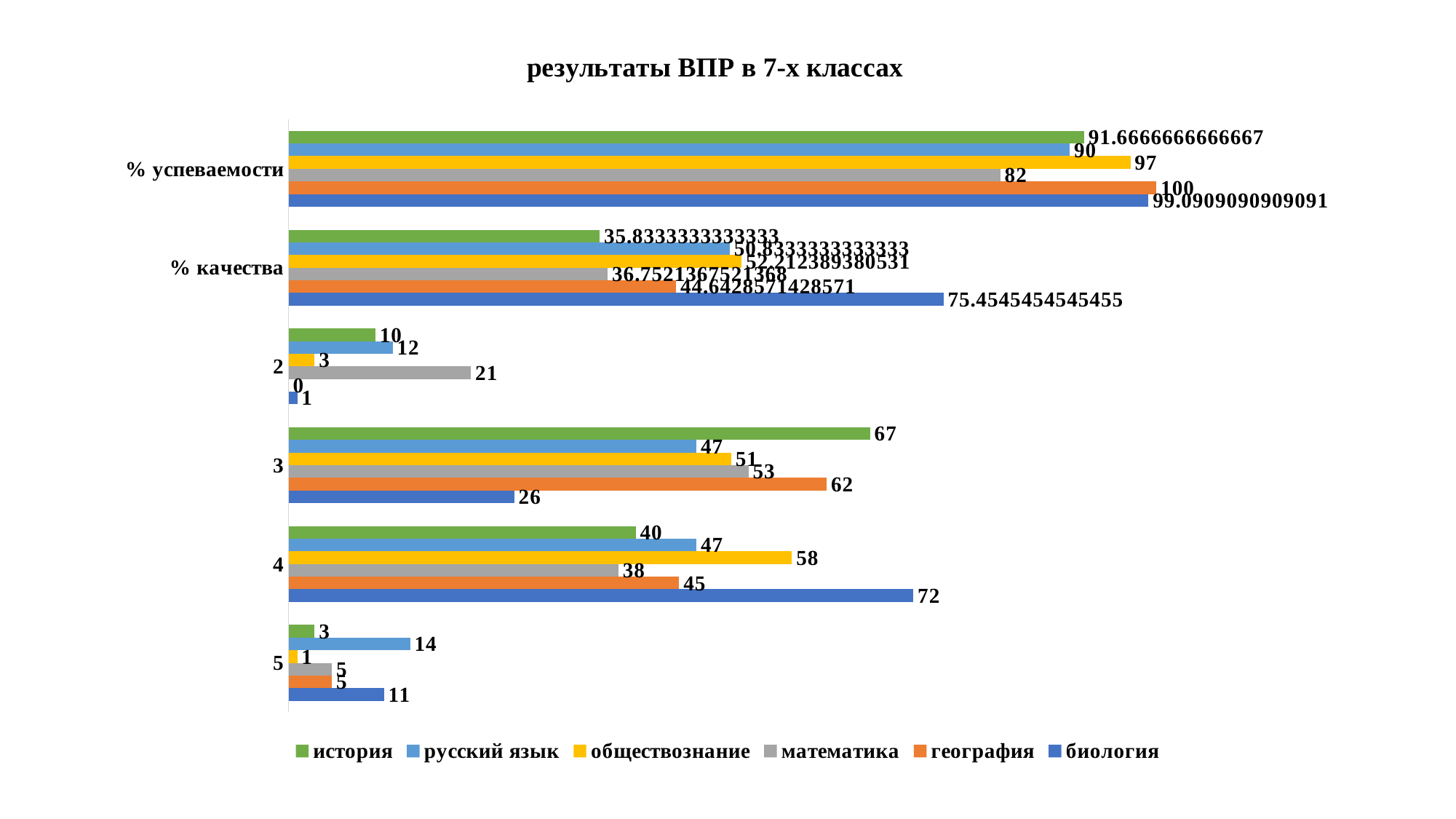
What is the value for биология in category 4? 72 What type of chart is shown on the slide? bar chart Which series has the highest value in category 3? история What is the value for русский язык in category 5? 14 What is the difference between обществознание and математика in category 4? 20 How many series does the legend list? 6 In category 3, which is larger: география or биология? география What is the value for биология in the % качества category? 75.4545454545455 What is the value for математика in category 2? 21 What is the title of the chart? результаты ВПР в 7-х классах Which series has the lowest value in the % успеваемости category? математика What is the value for география in the % успеваемости category? 100